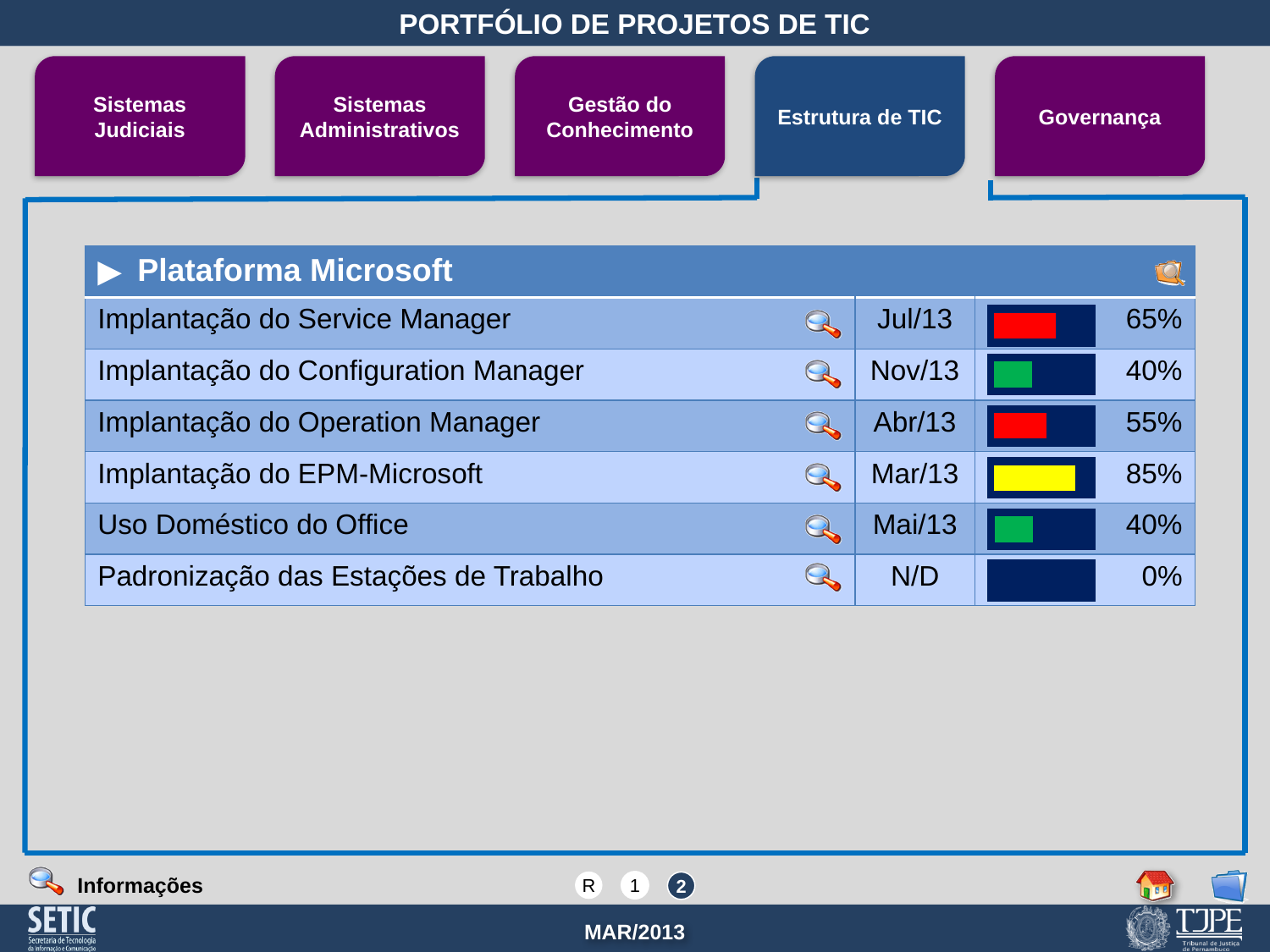
What is the completion percentage shown for Implantação do EPM-Microsoft? 85% What is the date shown for Implantação do Configuration Manager? Nov/13 What colour is the progress bar for Implantação do EPM-Microsoft? Yellow What is the completion percentage shown for Implantação do Service Manager? 65% What is the completion percentage shown for Implantação do Operation Manager? 55% What is the difference in completion percentage between Implantação do EPM-Microsoft and Implantação do Service Manager? 20% Which has a higher completion percentage, Implantação do Service Manager or Implantação do Operation Manager? Implantação do Service Manager How many projects are listed under Plataforma Microsoft? 6 Which project has the highest completion percentage? Implantação do EPM-Microsoft Which project has the lowest completion percentage? Padronização das Estações de Trabalho What is the completion percentage shown for Uso Doméstico do Office? 40% What kind of chart is used to show the completion of each project? Bar chart